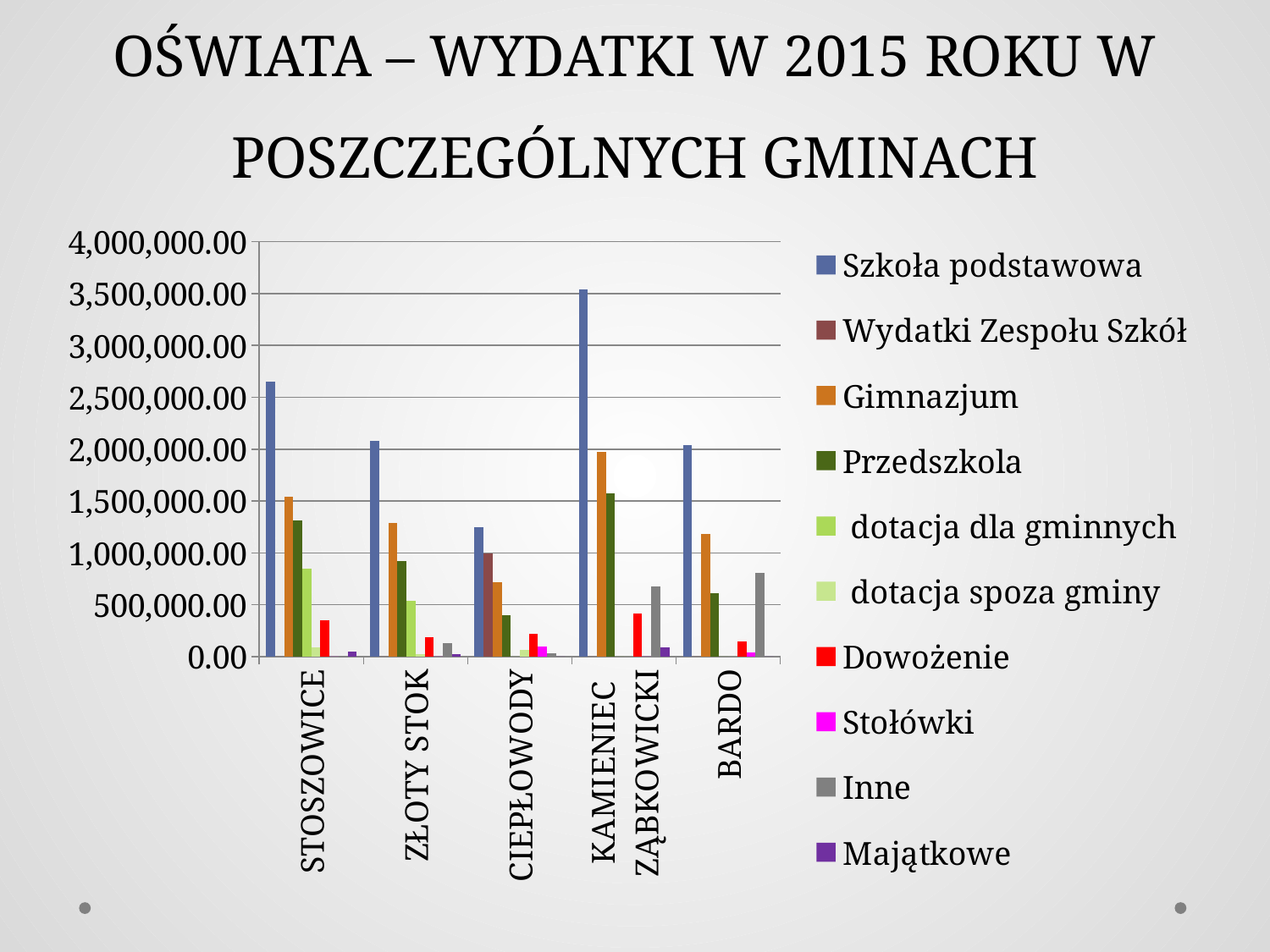
Is the Gimnazjum value for STOSZOWICE greater or less than 1,000,000.00? greater In ZŁOTY STOK, which is larger: Gimnazjum or Przedszkola? Gimnazjum How many gminas (categories) are shown on the x axis? 5 Is the Przedszkola value for CIEPŁOWODY greater or less than 500,000.00? less Which gmina has the highest value for Gimnazjum? KAMIENIEC ZĄBKOWICKI Which gmina has the lowest value for Szkoła podstawowa? CIEPŁOWODY What colour represents the Dowożenie series in the legend? red For Szkoła podstawowa, which is larger: STOSZOWICE or ZŁOTY STOK? STOSZOWICE What kind of chart is shown on the slide? bar chart Which gmina has the highest value for Szkoła podstawowa? KAMIENIEC ZĄBKOWICKI How many series does the legend list? 10 Is the Szkoła podstawowa value for KAMIENIEC ZĄBKOWICKI greater or less than 3,000,000.00? greater